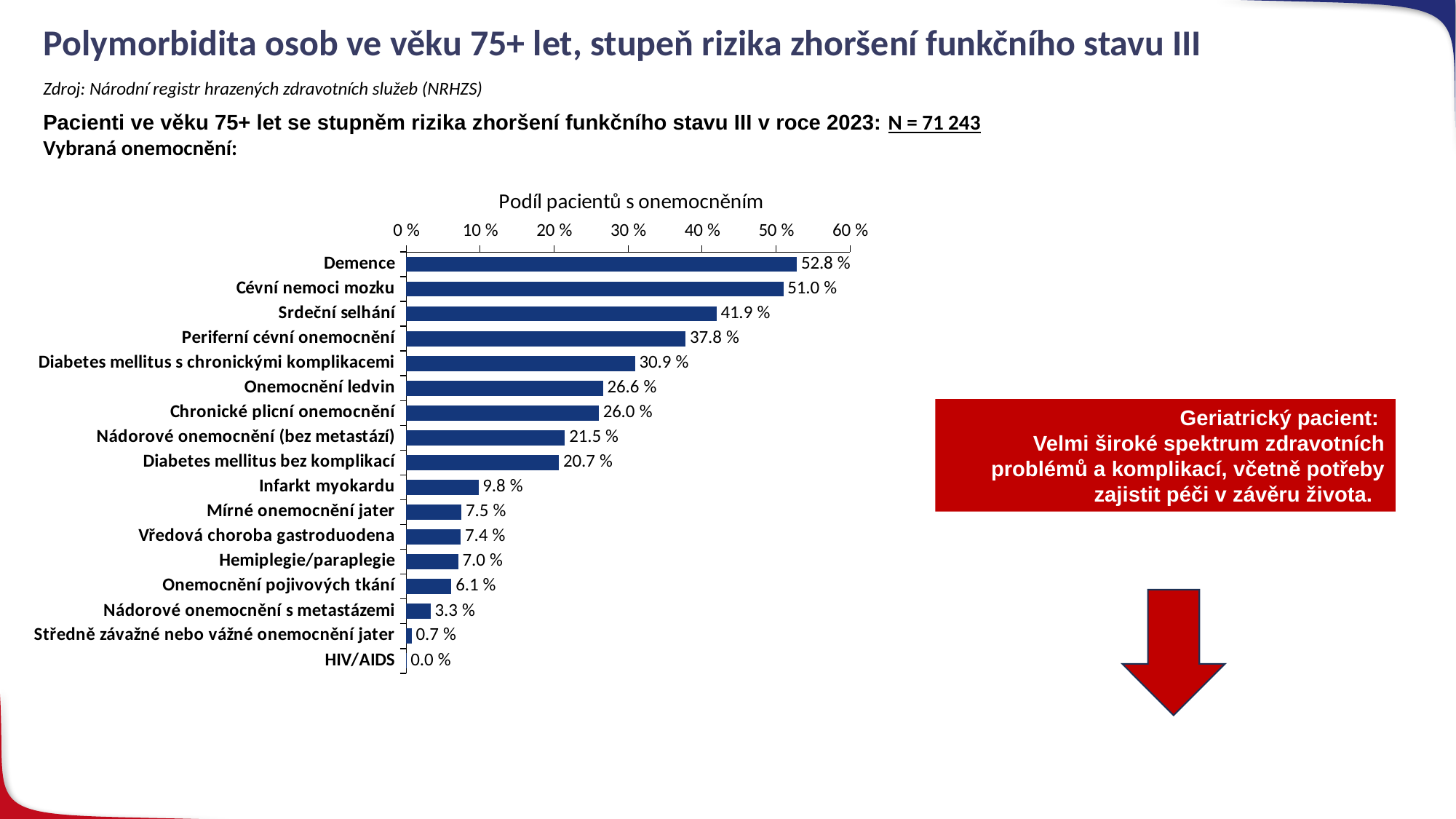
Which is larger, the value for Nádorové onemocnění (bez metastází) or Diabetes mellitus bez komplikací? Nádorové onemocnění (bez metastází) What is the title of the chart? Podíl pacientů s onemocněním What is the value for Onemocnění ledvin? 26.6 % What is the difference between the values for Srdeční selhání and Periferní cévní onemocnění? 4.1 % What is the difference between the values for Demence and Cévní nemoci mozku? 1.8 % How many categories are shown in the chart? 17 Is the value for Diabetes mellitus s chronickými komplikacemi greater or less than 30 %? greater Which category has the highest value? Demence What is the value for Demence? 52.8 % What is the value for Infarkt myokardu? 9.8 % Which category has the lowest value? HIV/AIDS What kind of chart is shown on the slide? bar chart